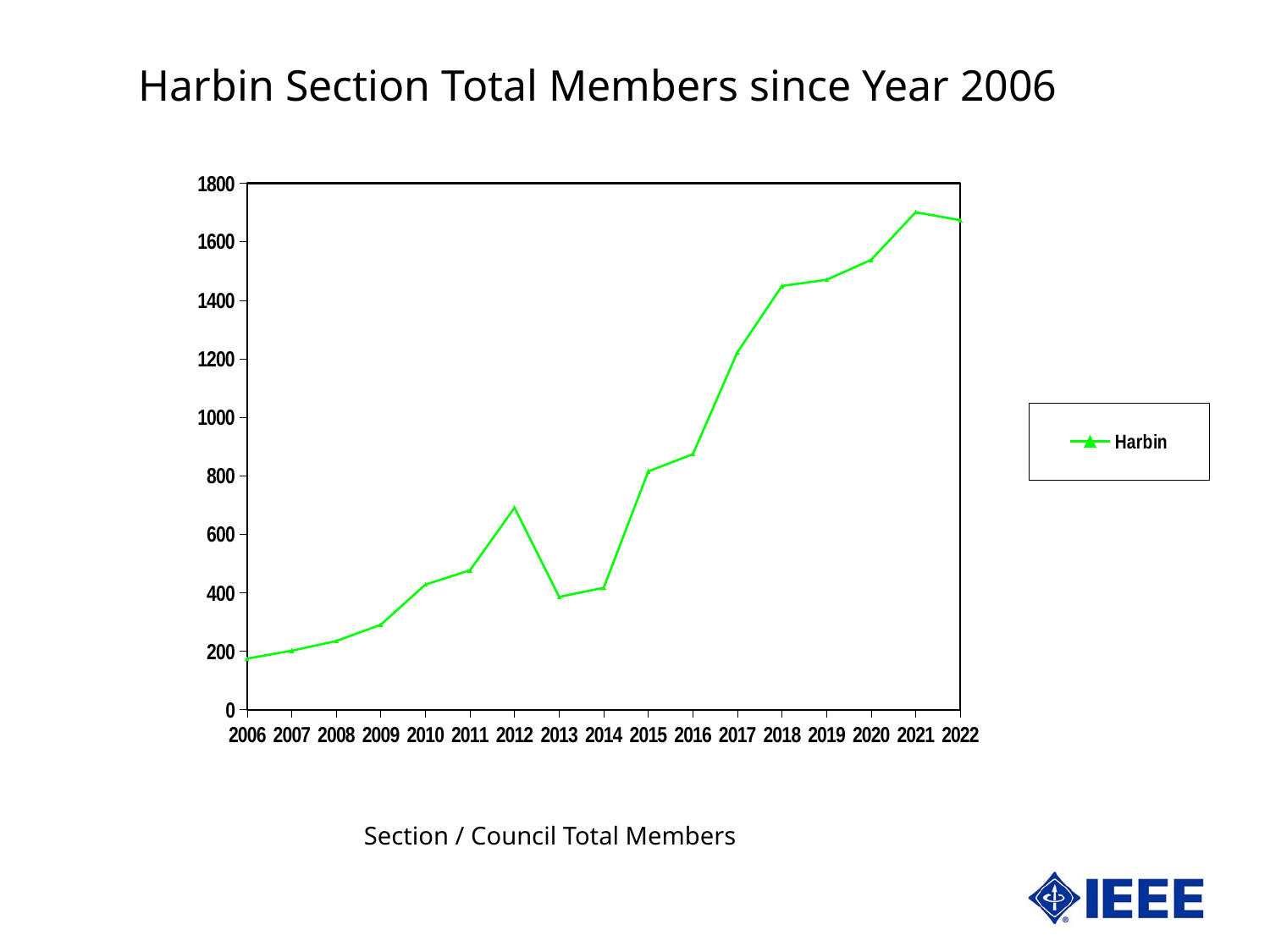
In which year is the number of Harbin Section members highest? 2021 Overall, do the Harbin Section member numbers rise or fall from 2006 to 2022? rise What kind of chart is shown on the slide? line chart In which year is the number of Harbin Section members lowest? 2006 What is the name of the series shown in the legend? Harbin Which year has more members, 2012 or 2013? 2012 How many series does the legend list? 1 How many years are plotted along the x axis? 17 Is the value for 2021 greater or less than 1600? greater Is the value for 2012 greater or less than 600? greater Is the value for 2018 greater or less than 1400? greater